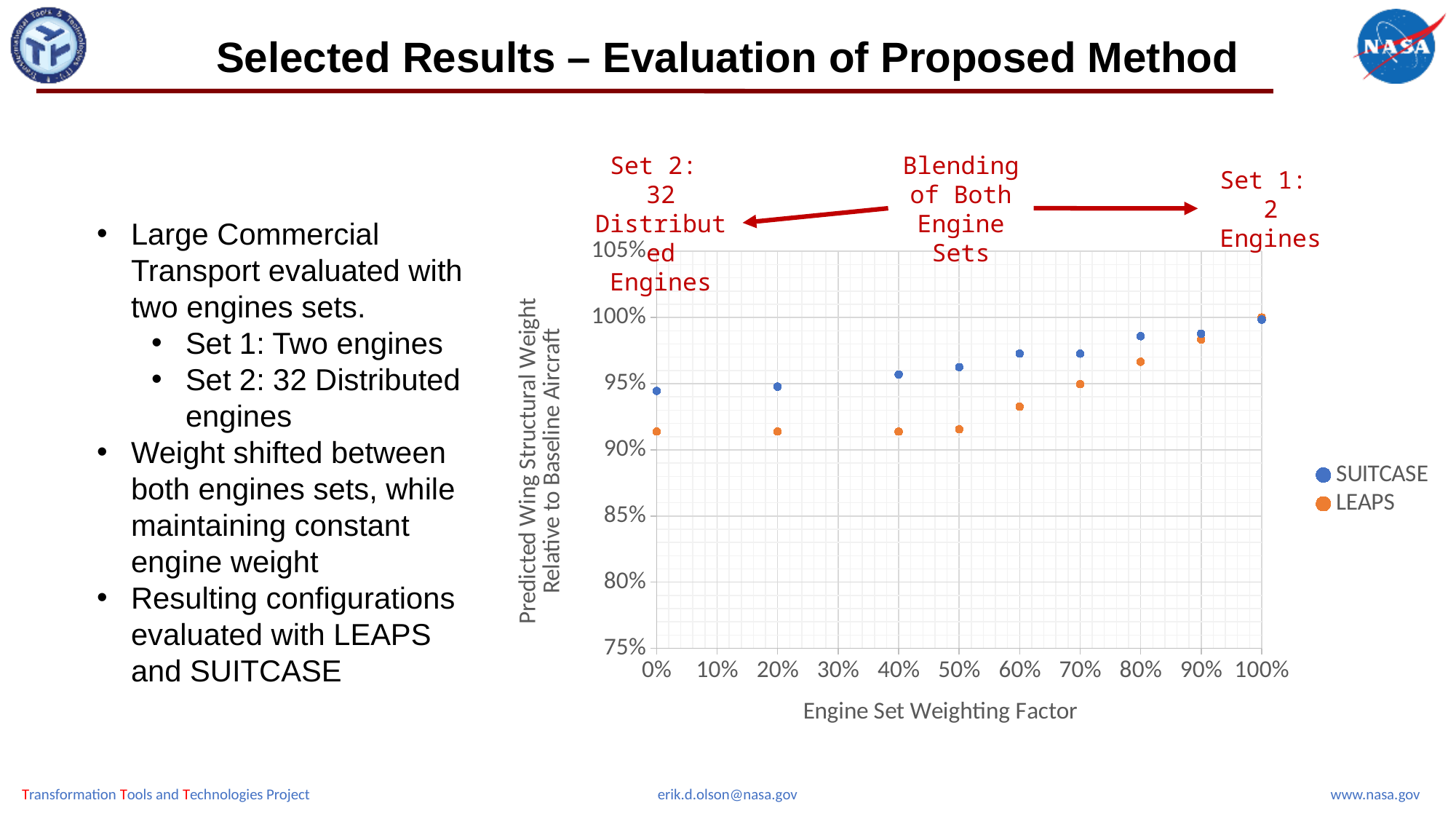
Is the LEAPS value at an Engine Set Weighting Factor of 60% greater or less than 95%? less Do the LEAPS values rise or fall as the Engine Set Weighting Factor increases from 0% to 100%? rise Which two series are listed in the chart legend? SUITCASE and LEAPS Is the SUITCASE value at an Engine Set Weighting Factor of 80% greater or less than 95%? greater Is the LEAPS value at an Engine Set Weighting Factor of 0% greater or less than 90%? greater At an Engine Set Weighting Factor of 70%, which series has the higher value, SUITCASE or LEAPS? SUITCASE What is the title of the x axis of the chart? Engine Set Weighting Factor How many series does the chart legend list? 2 What kind of chart is shown on the slide? scatter chart At which Engine Set Weighting Factor does the LEAPS series reach its highest value? 100% How many data points are plotted for the SUITCASE series? 9